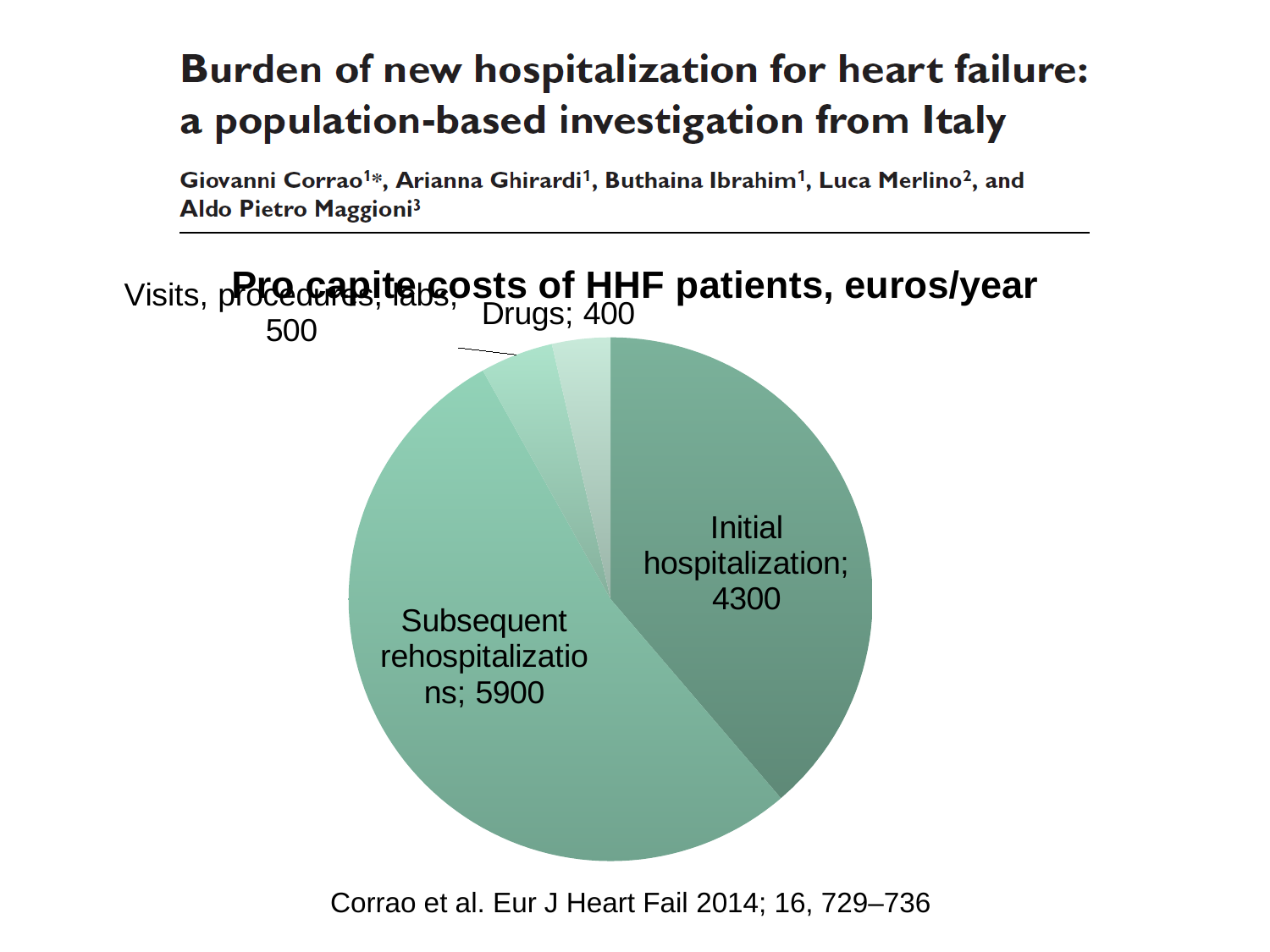
What is the value for Visits, procedures, labs in the pie chart? 500 What is the value for Drugs in the pie chart? 400 Which category has the largest slice of the pie chart? Subsequent rehospitalizations What is the title of the chart? Pro capite costs of HHF patients, euros/year What is the difference between the values for Subsequent rehospitalizations and Initial hospitalization? 1600 What is the value for Subsequent rehospitalizations in the pie chart? 5900 How many slices does the pie chart have? 4 What is the total of all four values shown in the pie chart? 11100 What kind of chart is shown on the slide? Pie chart What is the value for Initial hospitalization in the pie chart? 4300 Which category has the smallest slice of the pie chart? Drugs Which is larger, the value for Initial hospitalization or the value for Subsequent rehospitalizations? Subsequent rehospitalizations